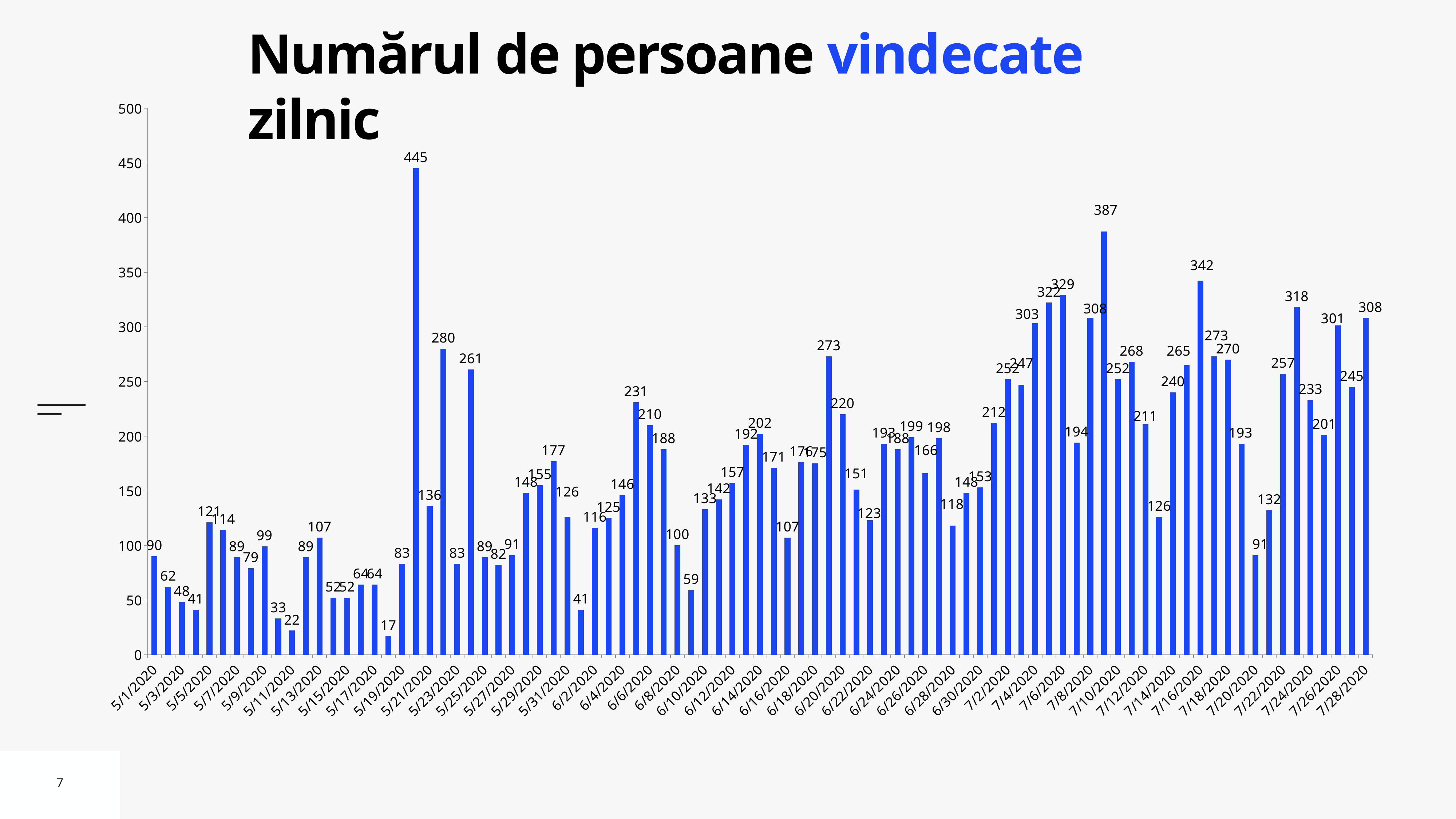
Which has the larger value, 7/6/2020 or 7/8/2020? 7/6/2020 What is the highest value shown in the chart? 445 Do the values rise or fall from 5/1/2020 to 5/3/2020? fall What is the value for 7/28/2020? 308 Is the value for 5/21/2020 greater or less than 150? less What kind of chart is shown on the slide? bar chart What is the value for 5/1/2020? 90 What is the value for 7/20/2020? 91 What is the difference between the values for 7/28/2020 and 7/26/2020? 7 What is the title of the chart? Numărul de persoane vindecate zilnic What is the value for 7/16/2020? 342 What is the lowest value shown in the chart? 17